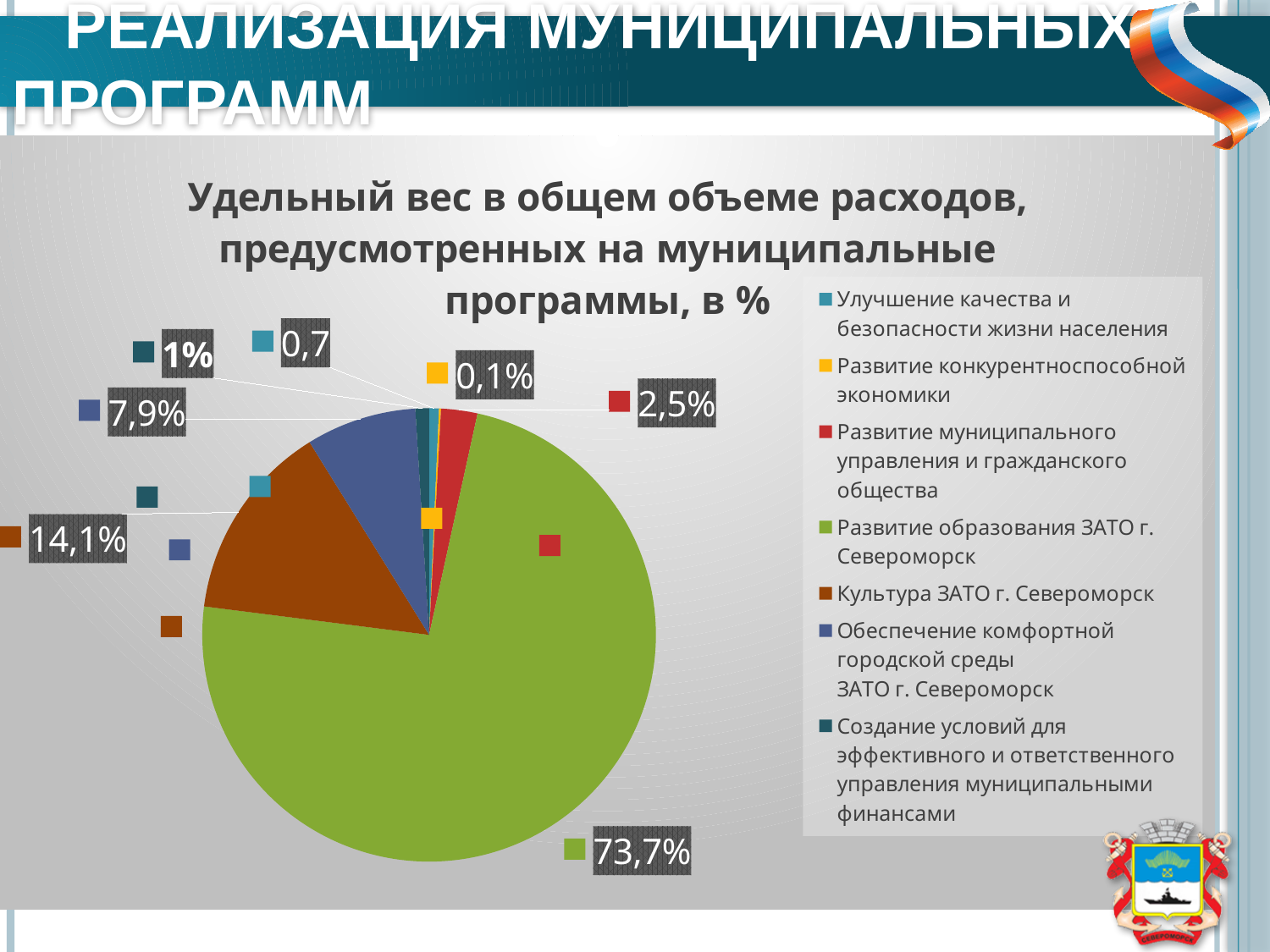
What is the share for "Культура ЗАТО г. Североморск"? 14,1% What is the title of the pie chart? Удельный вес в общем объеме расходов, предусмотренных на муниципальные программы, в % Which is larger: the share for "Культура ЗАТО г. Североморск" or for "Обеспечение комфортной городской среды ЗАТО г. Североморск"? Культура ЗАТО г. Североморск What is the share for "Развитие муниципального управления и гражданского общества"? 2,5% Which program has the largest share of expenditures in the pie chart? Развитие образования ЗАТО г. Североморск What is the share for "Развитие образования ЗАТО г. Североморск"? 73,7% Which program has the smallest share of expenditures in the pie chart? Развитие конкурентноспособной экономики How many slices does the pie chart have? 7 What kind of chart is shown on the slide? pie chart How many entries does the legend of the pie chart list? 7 What is the share for "Развитие конкурентноспособной экономики"? 0,1% What is the share for "Обеспечение комфортной городской среды ЗАТО г. Североморск"? 7,9%